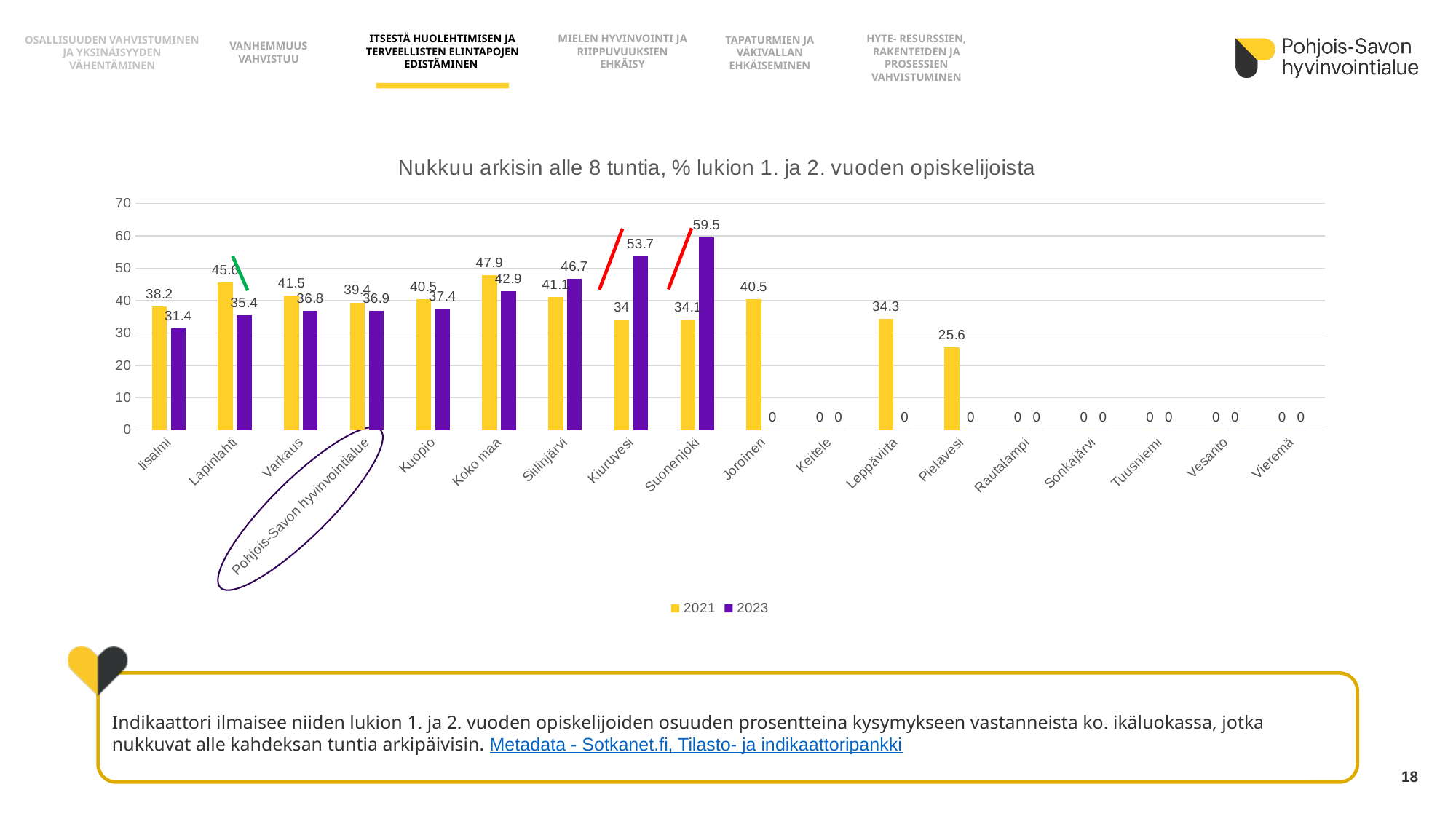
What is the 2021 value for Koko maa? 47.9 What is the difference between the 2021 and 2023 values for Iisalmi? 6.8 What is the difference between the 2023 and 2021 values for Kiuruvesi? 19.7 For Siilinjärvi, which series has the larger value, 2021 or 2023? 2023 What kind of chart is shown on the slide? Bar chart What is the title of the chart? Nukkuu arkisin alle 8 tuntia, % lukion 1. ja 2. vuoden opiskelijoista Which category has the highest 2021 value? Koko maa How many categories are shown on the x axis? 18 How many series does the legend list? 2 What is the 2023 value for Suonenjoki? 59.5 Which category has the highest 2023 value? Suonenjoki What is the 2021 value for Pielavesi? 25.6